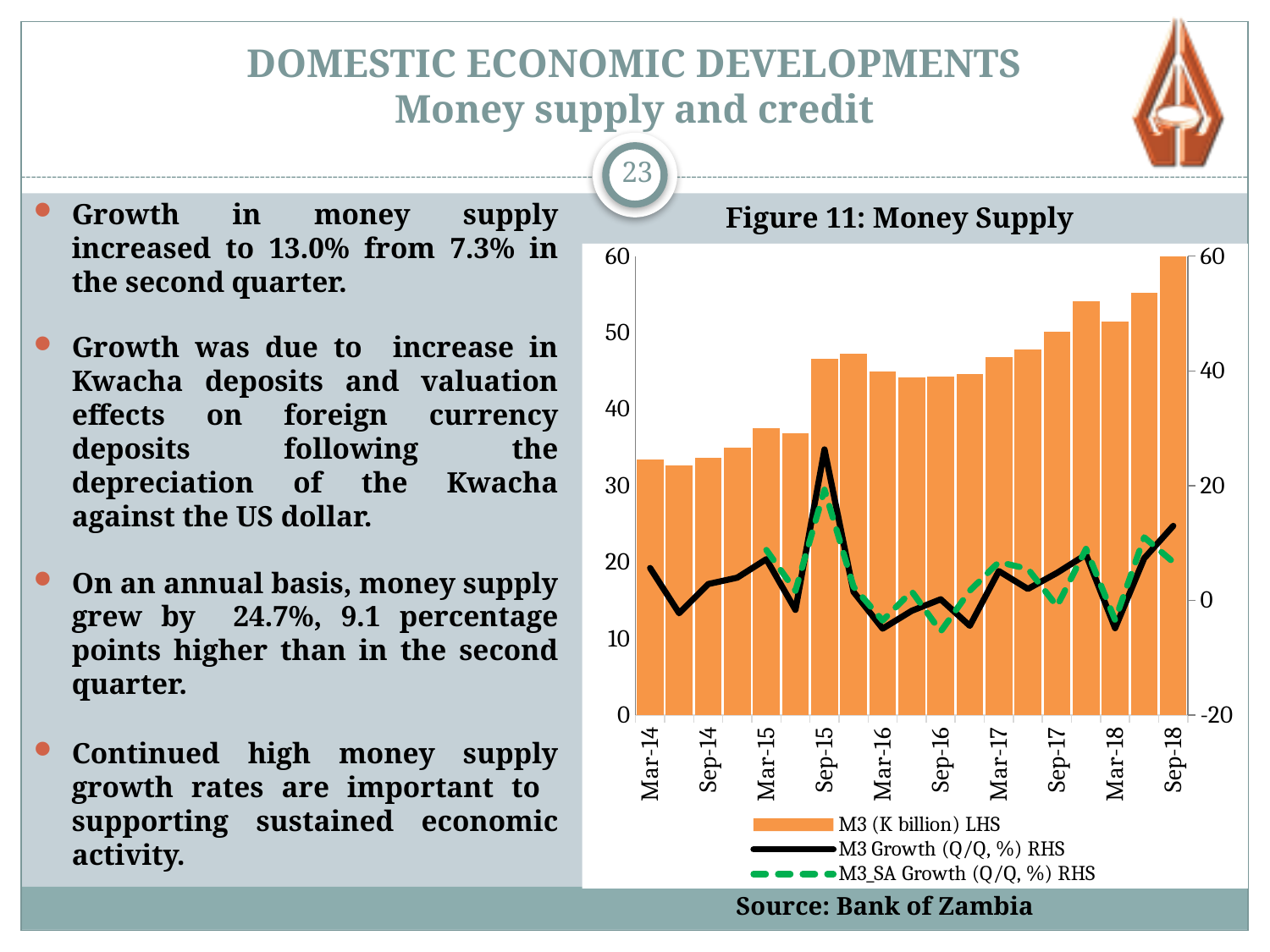
In Figure 11, is the M3 (K billion) bar for Sep-18 larger or smaller than the bar for Mar-14? larger In Figure 11, at which period does the M3 Growth (Q/Q, %) line reach its highest point? Sep-15 In Figure 11, is the M3 (K billion) bar for Mar-14 greater or less than 40? less In Figure 11, which period has the highest M3 (K billion) bar? Sep-18 Which series in Figure 11 is plotted as bars? M3 (K billion) LHS In Figure 11, is the M3 (K billion) bar for Sep-15 greater or less than 40? greater What is the title of the chart on the slide? Figure 11: Money Supply How many period labels are shown on the x axis of Figure 11? 10 In Figure 11, is the M3 (K billion) bar for Sep-18 greater or less than 50? greater What kind of chart is Figure 11: Money Supply? Combined bar and line chart How many series does the chart legend list? 3 In Figure 11, do the M3 (K billion) bars generally rise or fall from Mar-14 to Sep-18? rise